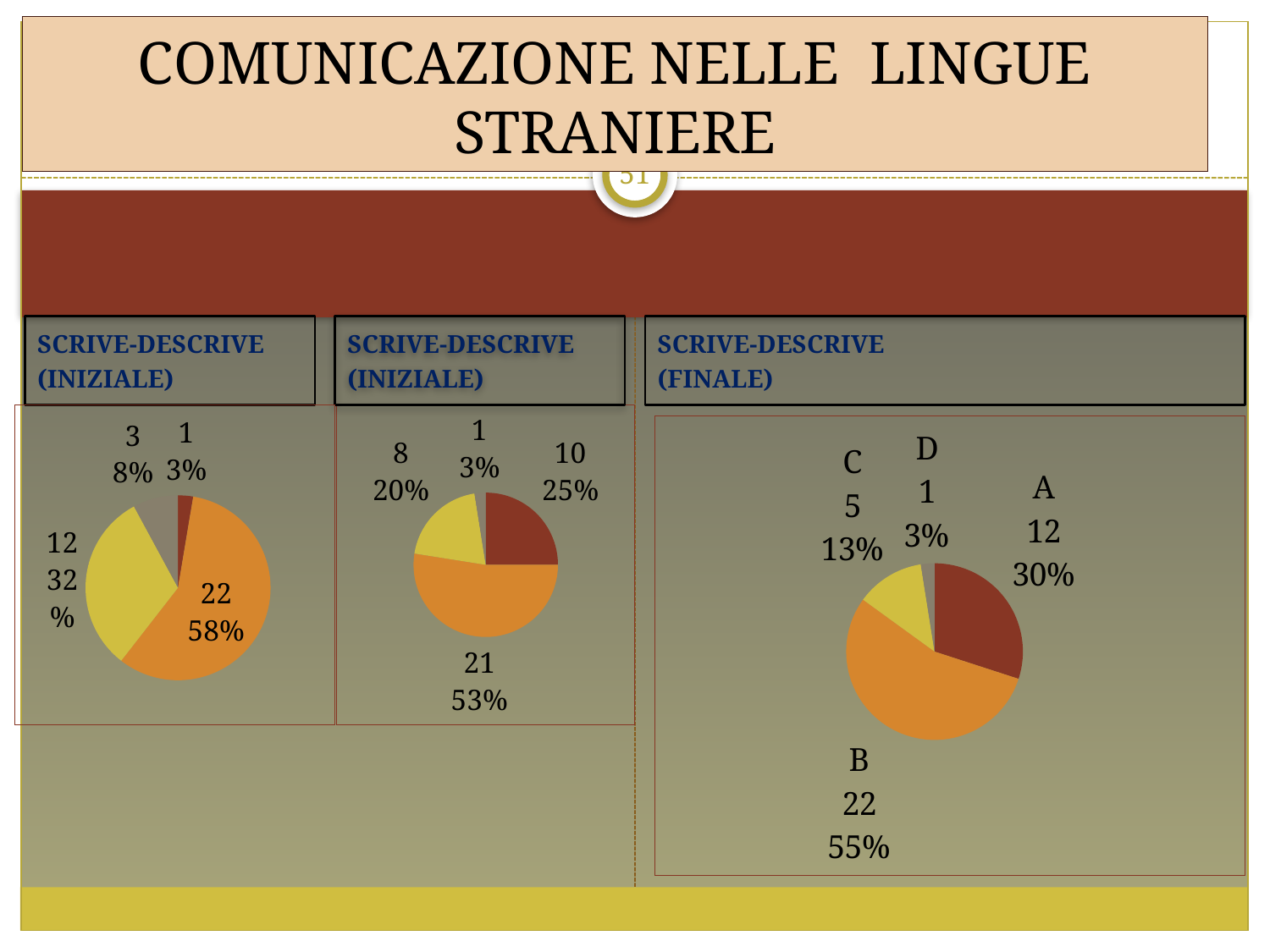
In the SCRIVE-DESCRIVE (FINALE) chart on the right, what is the value for category B? 22 In the leftmost SCRIVE-DESCRIVE (INIZIALE) chart, what percentage share does the slice with value 12 have? 32% In the SCRIVE-DESCRIVE (FINALE) chart on the right, what percentage share does category A have? 30% In the SCRIVE-DESCRIVE (FINALE) chart on the right, which is larger, the value for C or the value for D? C In the SCRIVE-DESCRIVE (FINALE) chart on the right, which category has the smallest slice? D How many pie charts are shown on the slide? 3 What kind of chart is the SCRIVE-DESCRIVE (FINALE) chart on the right? pie chart In the SCRIVE-DESCRIVE (FINALE) chart on the right, which category has the largest slice? B In the SCRIVE-DESCRIVE (FINALE) chart on the right, how many categories are shown? 4 In the middle SCRIVE-DESCRIVE (INIZIALE) chart, what percentage share does the slice with value 21 have? 53% In the leftmost SCRIVE-DESCRIVE (INIZIALE) chart, what is the value of the largest slice? 22 In the SCRIVE-DESCRIVE (FINALE) chart on the right, what is the difference between the values for B and A? 10